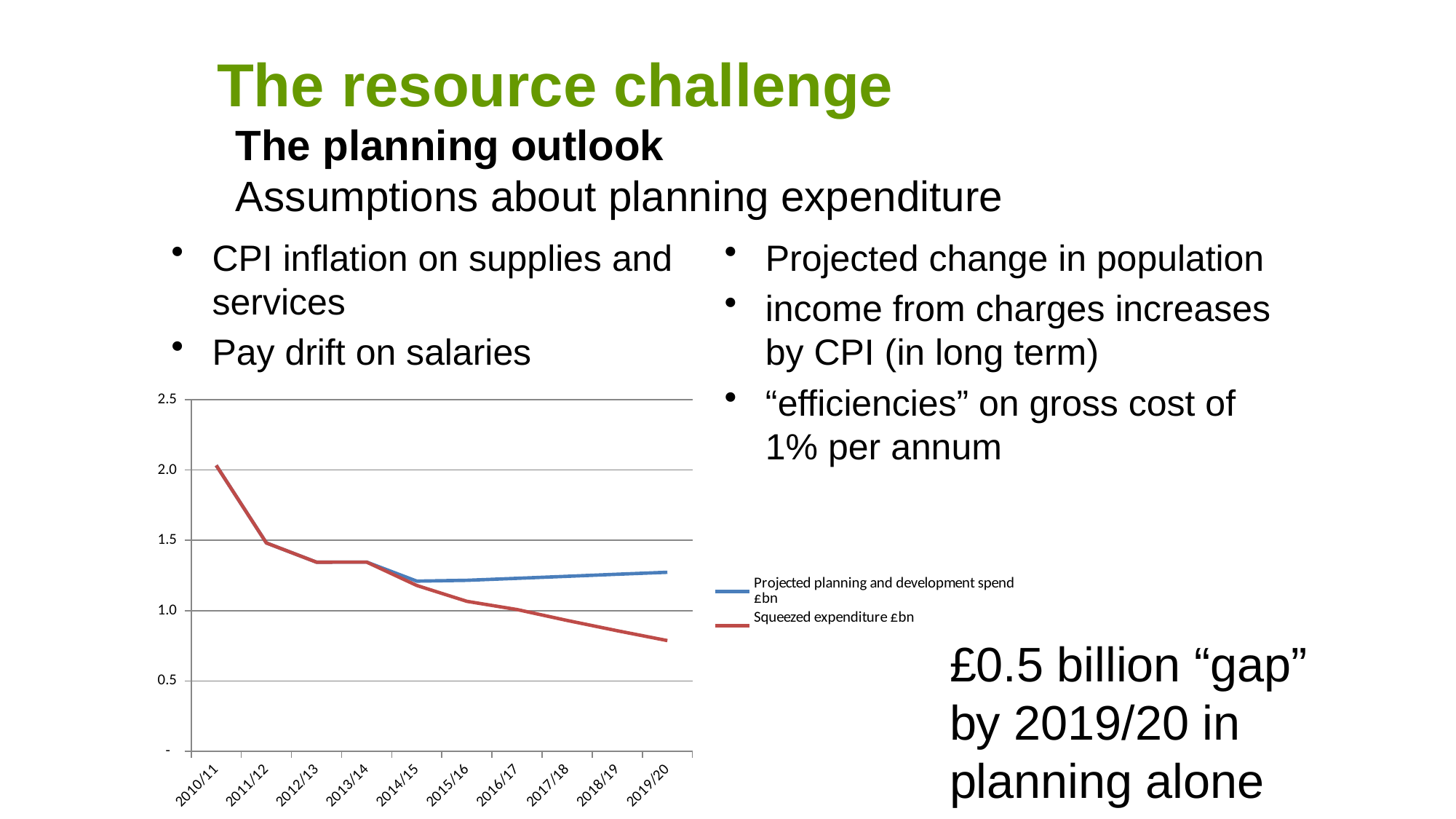
Is the value for Squeezed expenditure £bn in 2010/11 greater or less than 1.5? greater Which series is drawn in red on the chart? Squeezed expenditure £bn What kind of chart is shown on the slide? line chart Does the Squeezed expenditure £bn series rise or fall from 2010/11 to 2019/20? fall Which series is drawn in blue on the chart? Projected planning and development spend £bn In which year is Squeezed expenditure £bn highest? 2010/11 Does the Projected planning and development spend £bn series rise or fall from 2014/15 to 2019/20? rise How many series does the chart's legend list? 2 How many years are plotted along the x axis of the chart? 10 Is the value for Squeezed expenditure £bn in 2019/20 greater or less than 1.0? less In which year is Squeezed expenditure £bn lowest? 2019/20 In 2019/20, which series has the larger value: Projected planning and development spend £bn or Squeezed expenditure £bn? Projected planning and development spend £bn